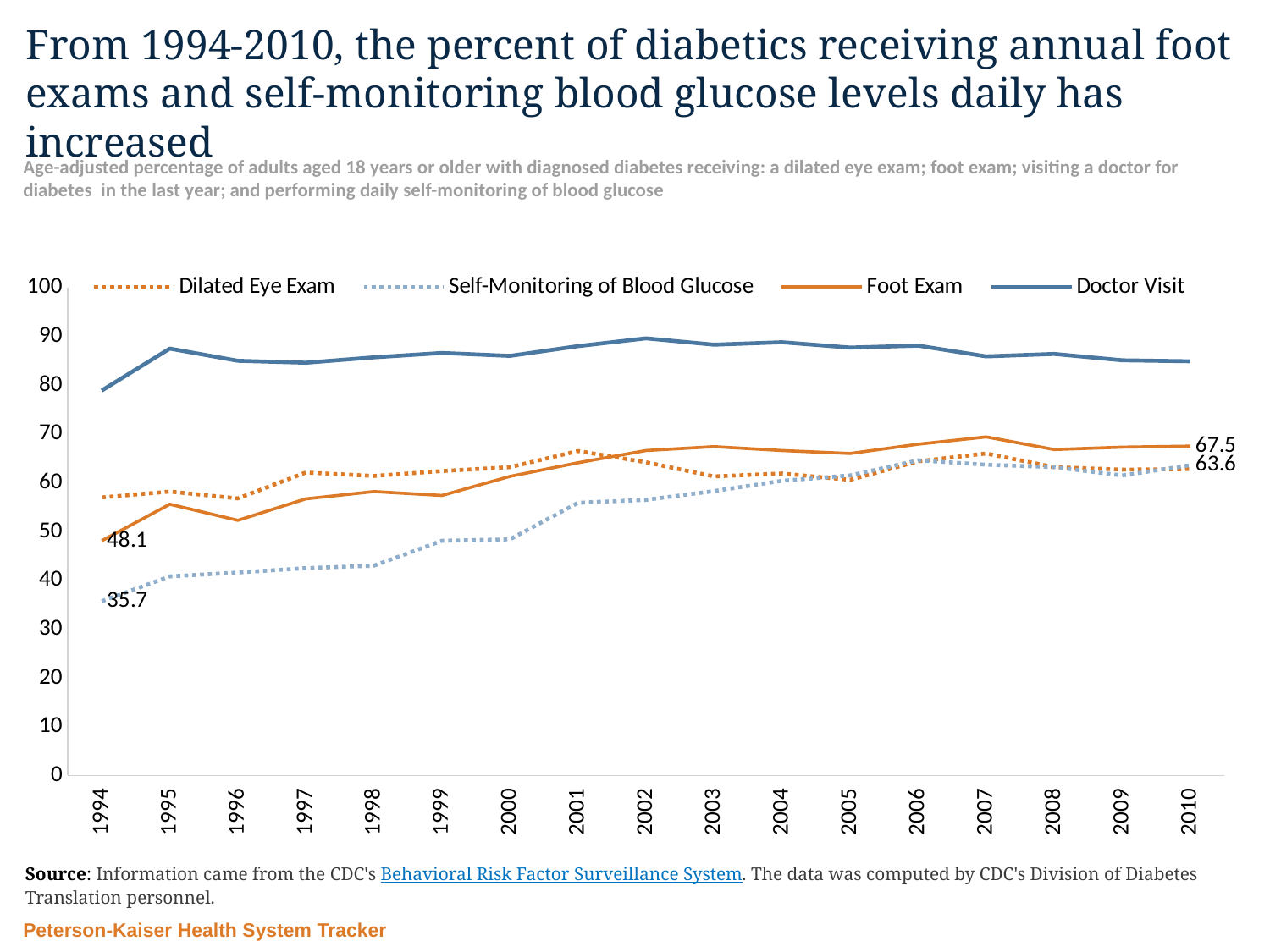
How many series does the legend list? 4 What was the percentage of diabetics receiving a foot exam in 2010? 67.5 By how many percentage points did the Foot Exam value increase from 1994 to 2010? 19.4 How many years are shown on the x axis? 17 What was the percentage of diabetics performing daily self-monitoring of blood glucose in 2010? 63.6 What was the percentage of diabetics receiving a foot exam in 1994? 48.1 What kind of chart is shown on the slide? Line chart Is the Doctor Visit value in 1994 greater or less than 70? greater Does the Self-Monitoring of Blood Glucose line rise or fall from 1994 to 2010? Rise By how many percentage points did the Self-Monitoring of Blood Glucose value increase from 1994 to 2010? 27.9 What was the percentage of diabetics performing daily self-monitoring of blood glucose in 1994? 35.7 Which series has the highest value in 2010? Doctor Visit